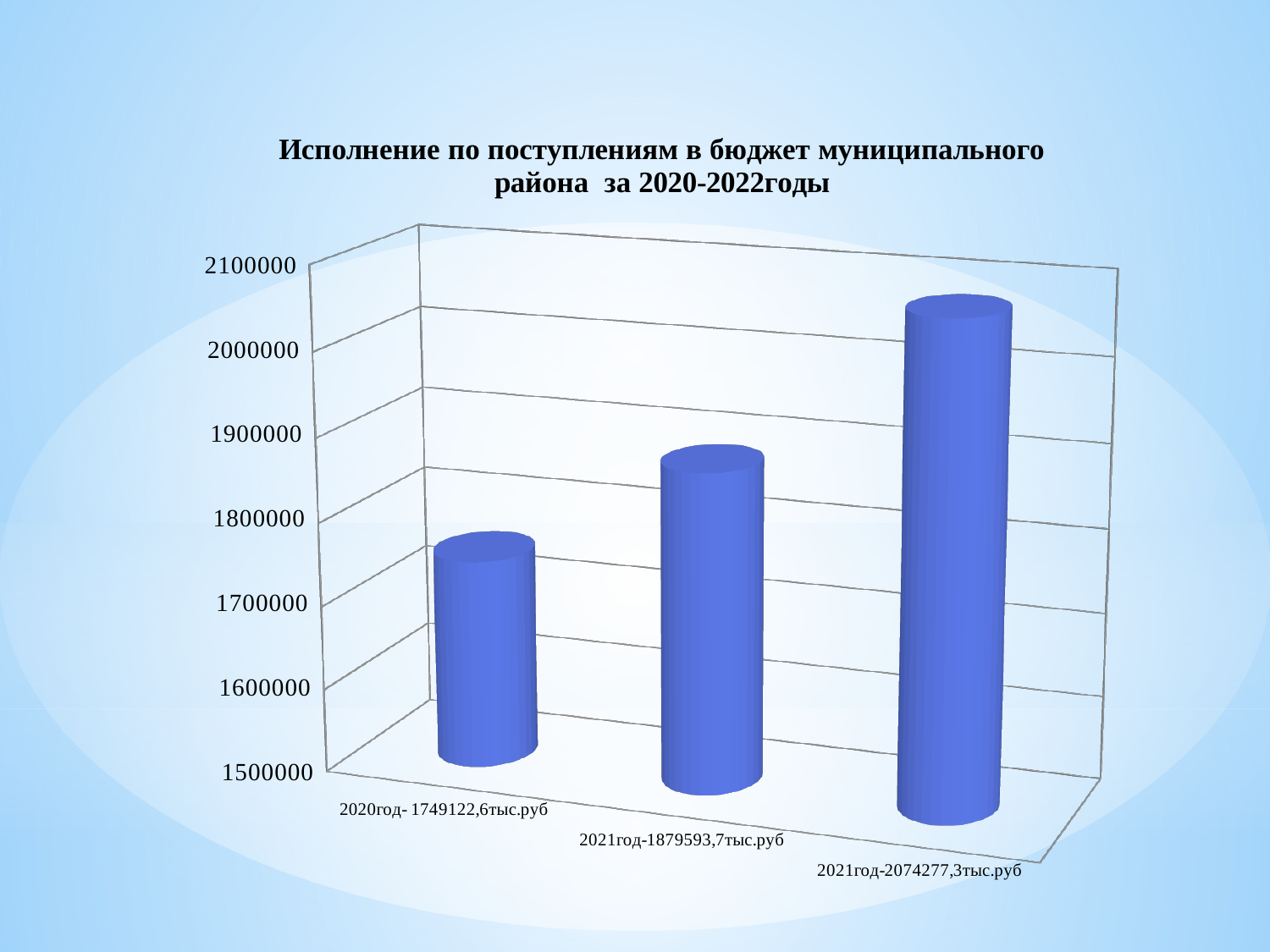
How many bars does the chart contain? 3 According to its category label, what value is shown for the middle bar? 1879593,7тыс.руб What kind of chart is shown on the slide? bar chart Which bar is the lowest? the leftmost bar (2020год, 1749122,6тыс.руб) According to its category label, what value is shown for the leftmost bar (2020год)? 1749122,6тыс.руб What is the difference between the middle bar's value and the leftmost bar's value, using the values printed in the category labels? 130471,1тыс.руб According to its category label, what value is shown for the rightmost bar? 2074277,3тыс.руб Is the value for the leftmost bar (2020год) greater or less than 1800000? less Which bar is the highest? the rightmost bar (2074277,3тыс.руб) Do the values rise or fall from left to right across the bars? rise What is the difference between the rightmost bar's value and the leftmost bar's value, using the values printed in the category labels? 325154,7тыс.руб What is the title of the chart? Исполнение по поступлениям в бюджет муниципального района за 2020-2022годы